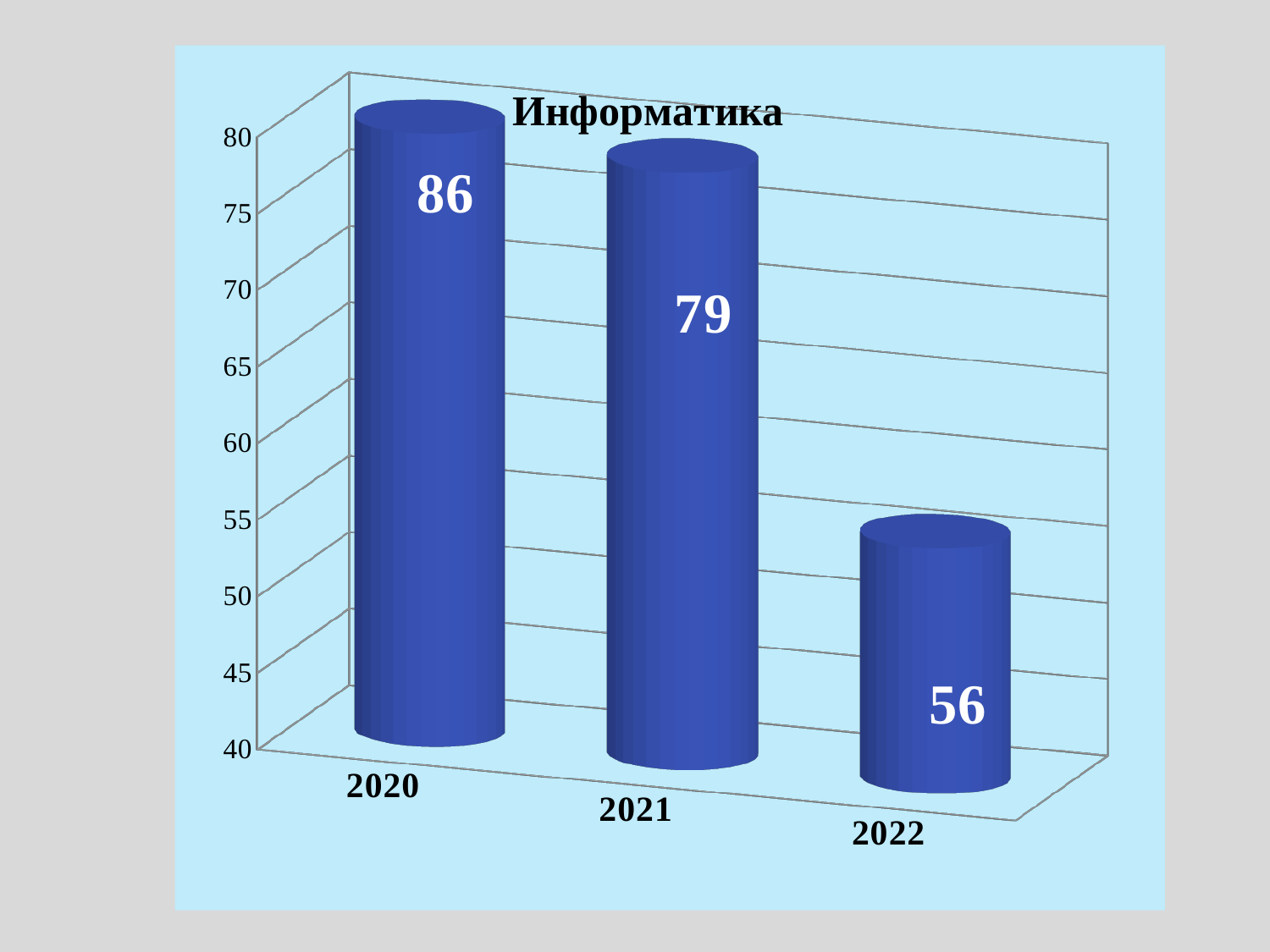
What is the value for 2021? 79 What is the value for 2020? 86 Which is larger, the value for 2021 or the value for 2022? 2021 Which year has the highest value? 2020 Which year has the lowest value? 2022 How many years are shown on the chart? 3 What is the difference between the values for 2020 and 2021? 7 What is the title of the chart? Информатика What is the difference between the values for 2020 and 2022? 30 What kind of chart is shown on the slide? bar chart Is the value for 2022 greater or less than 60? less What is the value for 2022? 56